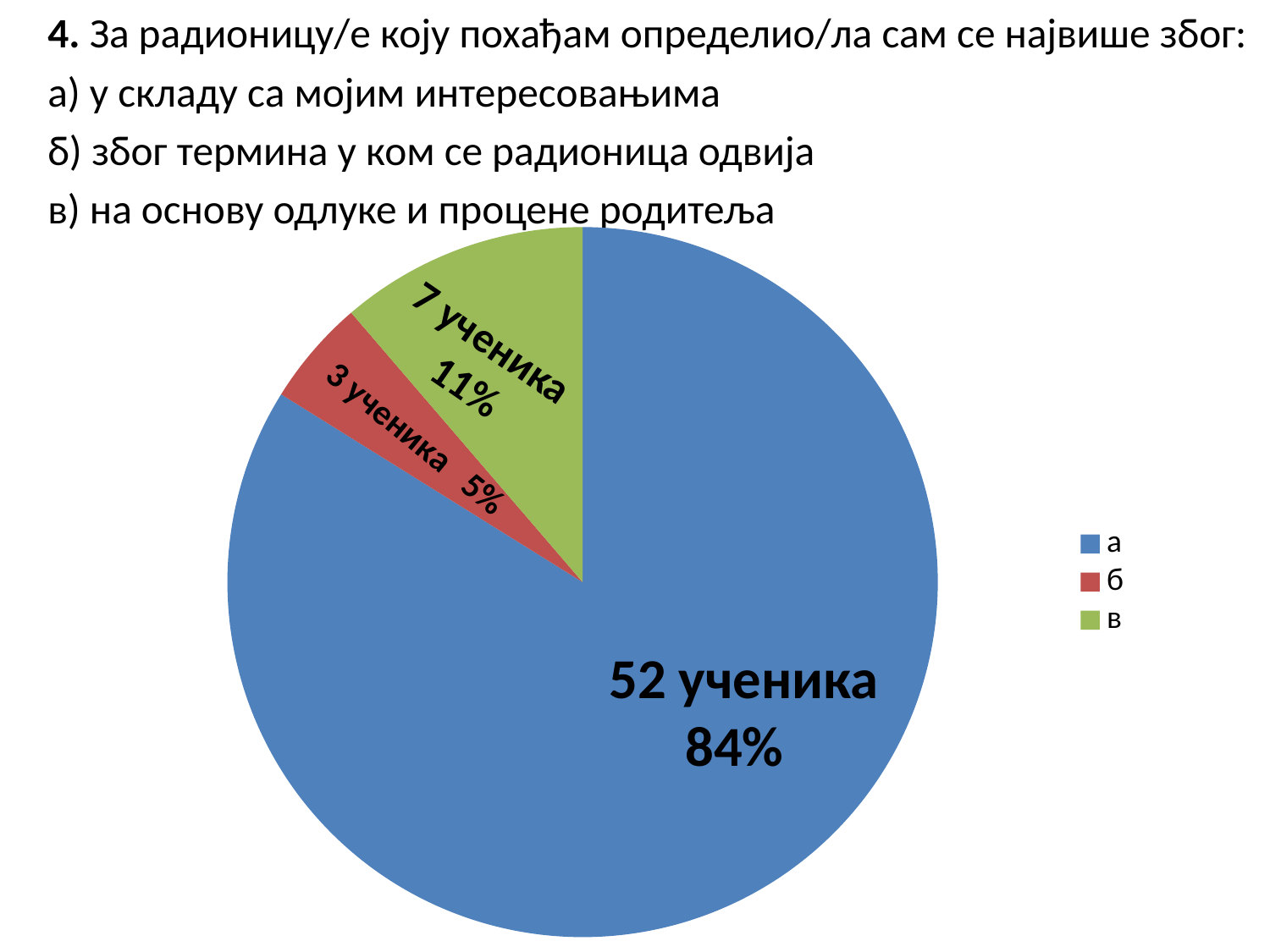
How many entries does the legend list? 3 What percentage share does slice в have? 11% How many slices does the pie chart have? 3 Which slice is the largest? а What is the difference in number of students between slice а and slice в? 45 How many students are in slice а? 52 ученика How many students are in slice в? 7 ученика Which colour is used for slice в in the pie chart? green What percentage share does slice а have? 84% What kind of chart is shown on the slide? pie chart Which slice is the smallest? б What percentage share does slice б have? 5%